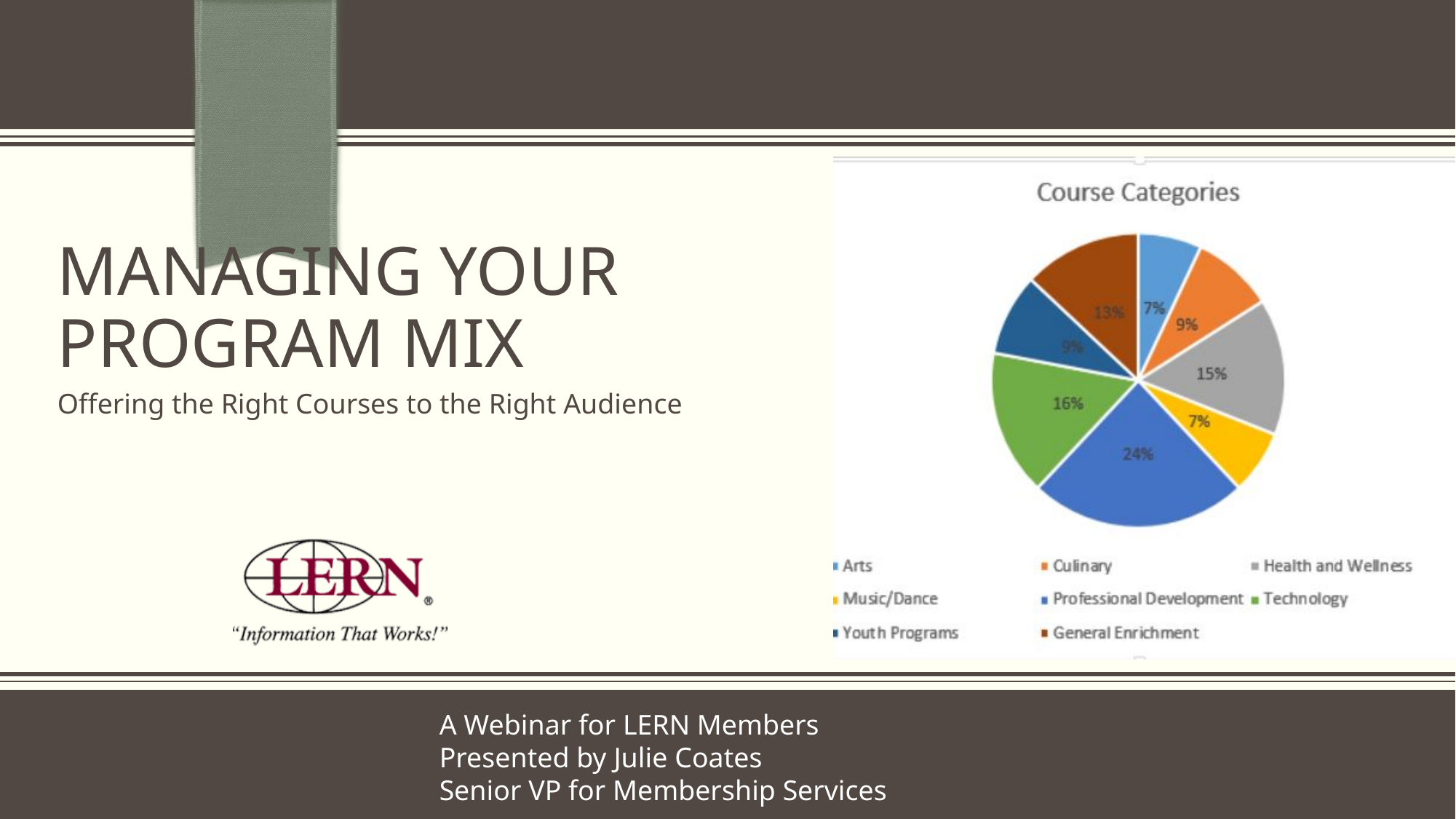
What share of the pie is Technology? 16% Which category has the largest share of the pie? Professional Development What share of the pie is General Enrichment? 13% What is the combined share of Arts and Music/Dance? 14% What is the difference between the Professional Development share and the General Enrichment share? 11% What share of the pie is Culinary? 9% How many categories does the pie chart show? 8 What is the title of the chart? Course Categories What share of the pie is Professional Development? 24% Which is larger, the share for Technology or the share for Health and Wellness? Technology What share of the pie is Health and Wellness? 15% What kind of chart is shown on the slide? Pie chart